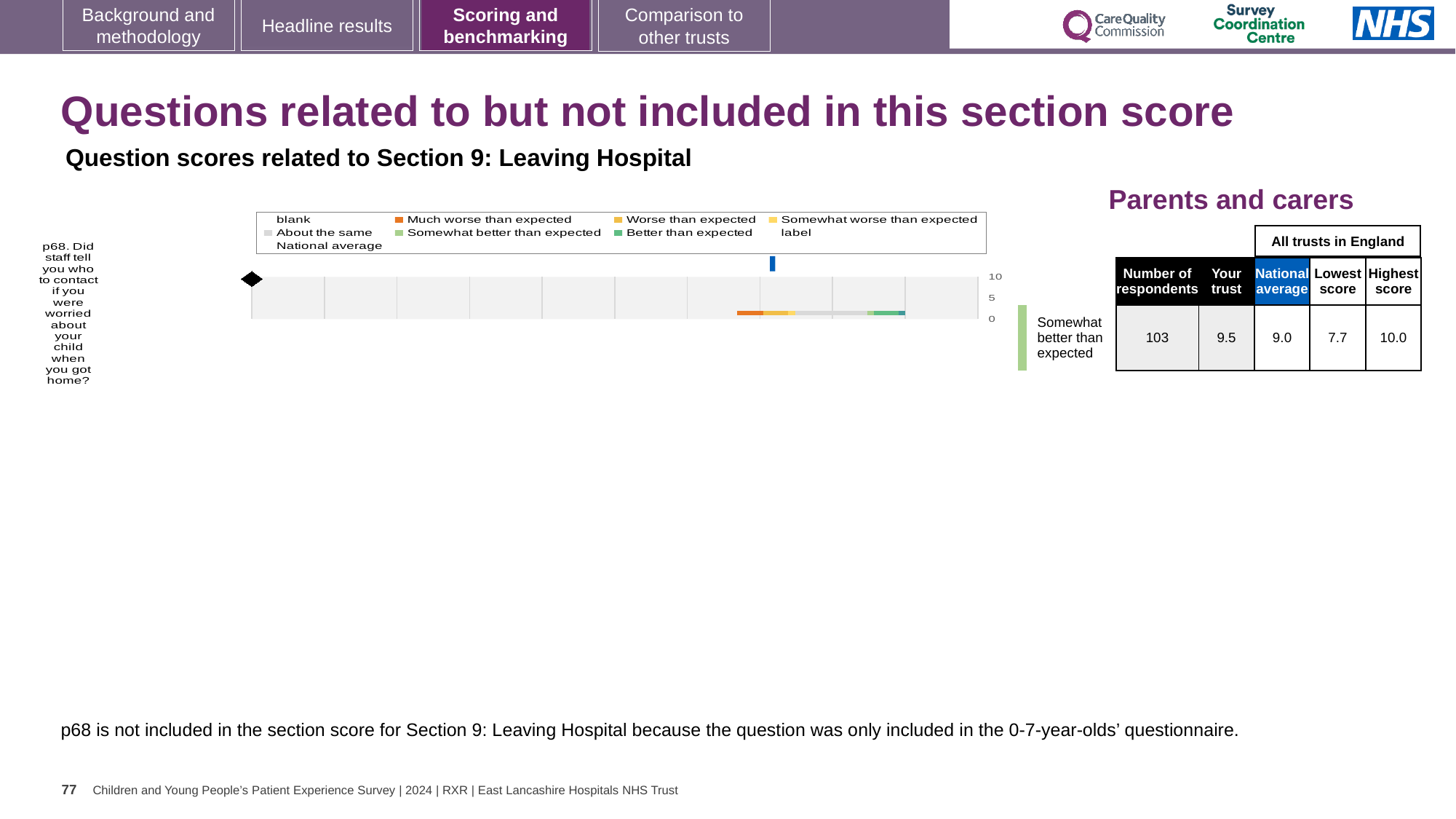
Which group of respondents does the chart cover? Parents and carers How many respondents answered p68? 103 How many questions are plotted in the chart? 1 Which is higher for p68, the 'Your trust' score or the national average? Your trust What is the national average score for p68? 9.0 What is the lowest score among all trusts in England for p68? 7.7 What is the difference between the highest and lowest scores among all trusts in England for p68? 2.3 What is the 'Your trust' score for p68? 9.5 What kind of chart is used to show the p68 question score? bar chart Which benchmarking category is the trust's p68 score placed in? Somewhat better than expected What is the highest score among all trusts in England for p68? 10.0 What is the difference between the 'Your trust' score and the national average for p68? 0.5